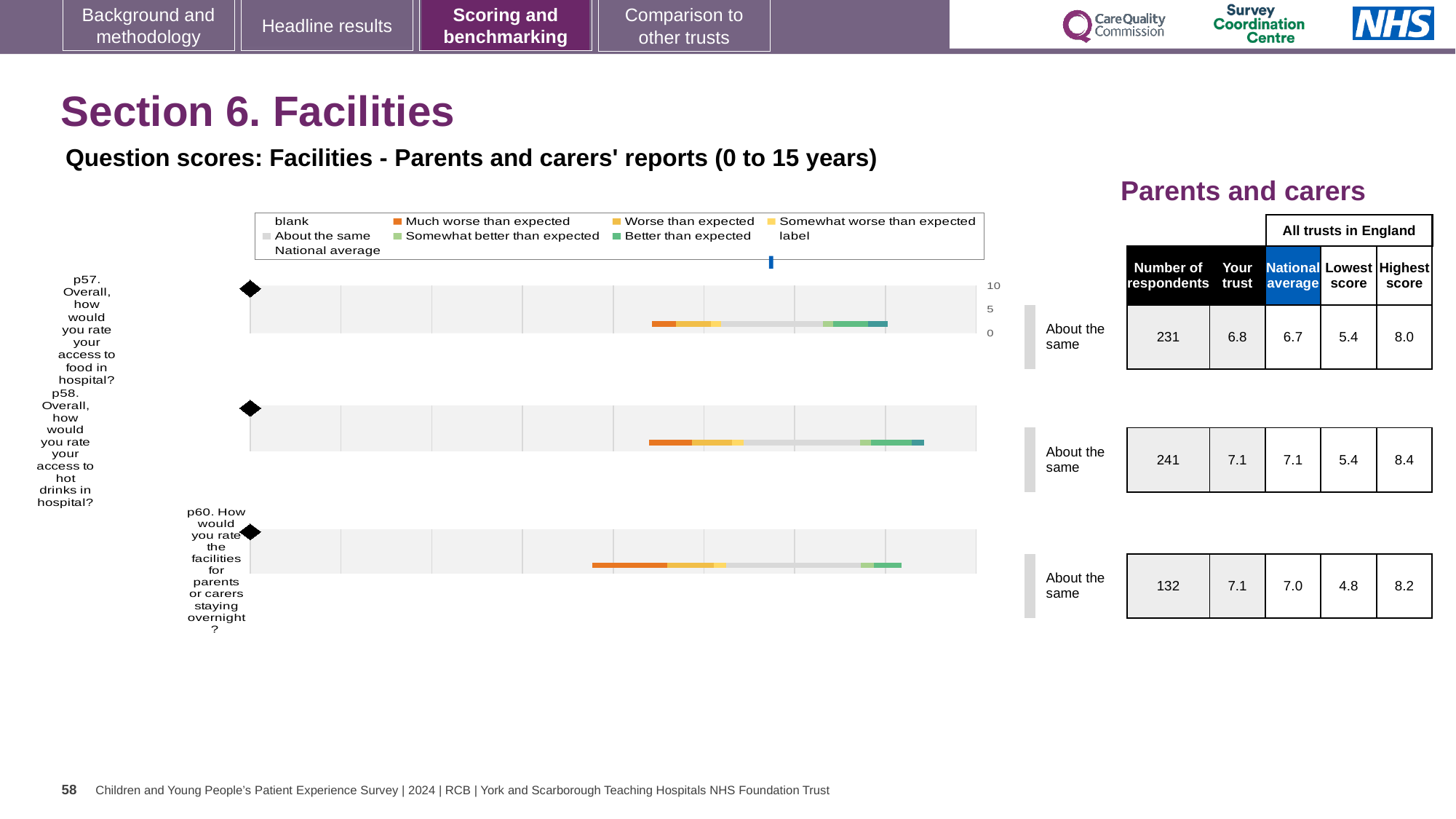
What is the 'Your trust' score for p57 (access to food in hospital)? 6.8 How many respondents answered p60 (facilities for parents or carers staying overnight)? 132 What kind of chart is used to show the question scores on this slide? bar chart What is the difference between the highest score and the lowest score for p57? 2.6 Which question has the lowest 'Lowest score' across all trusts in England? p60 What is the national average score for p58 (access to hot drinks in hospital)? 7.1 For p57, which is larger: the 'Your trust' score or the national average? Your trust What is the highest value shown on the score axis of the charts? 10 Which question has the highest 'Highest score' across all trusts in England? p58 In the chart legend, which colour represents 'Much worse than expected'? orange What benchmark category is shown for all three questions? About the same How many question charts are shown on the slide? 3